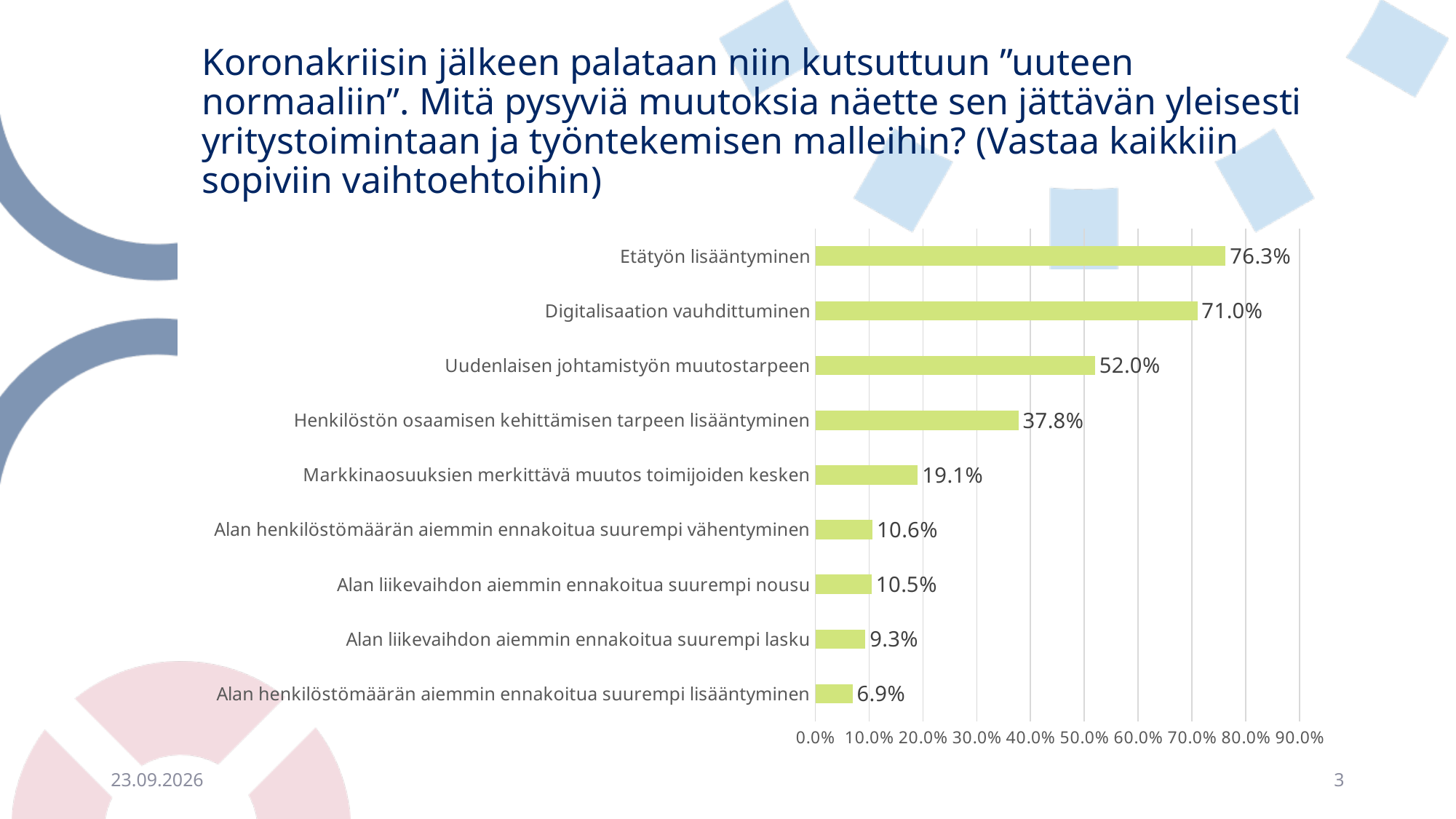
What is the value for "Alan liikevaihdon aiemmin ennakoitua suurempi lasku"? 9.3% What is the value for "Etätyön lisääntyminen"? 76.3% What is the difference between the values for "Uudenlaisen johtamistyön muutostarpeen" and "Henkilöstön osaamisen kehittämisen tarpeen lisääntyminen"? 14.2% Is the value for "Digitalisaation vauhdittuminen" greater or less than 60.0%? greater What is the difference between the values for "Etätyön lisääntyminen" and "Digitalisaation vauhdittuminen"? 5.3% How many categories are shown in the chart? 9 Which is larger: the value for "Henkilöstön osaamisen kehittämisen tarpeen lisääntyminen" or "Markkinaosuuksien merkittävä muutos toimijoiden kesken"? Henkilöstön osaamisen kehittämisen tarpeen lisääntyminen What is the value for "Markkinaosuuksien merkittävä muutos toimijoiden kesken"? 19.1% What kind of chart is shown on the slide? Bar chart Which category has the highest value? Etätyön lisääntyminen Which category has the lowest value? Alan henkilöstömäärän aiemmin ennakoitua suurempi lisääntyminen What is the value for "Uudenlaisen johtamistyön muutostarpeen"? 52.0%